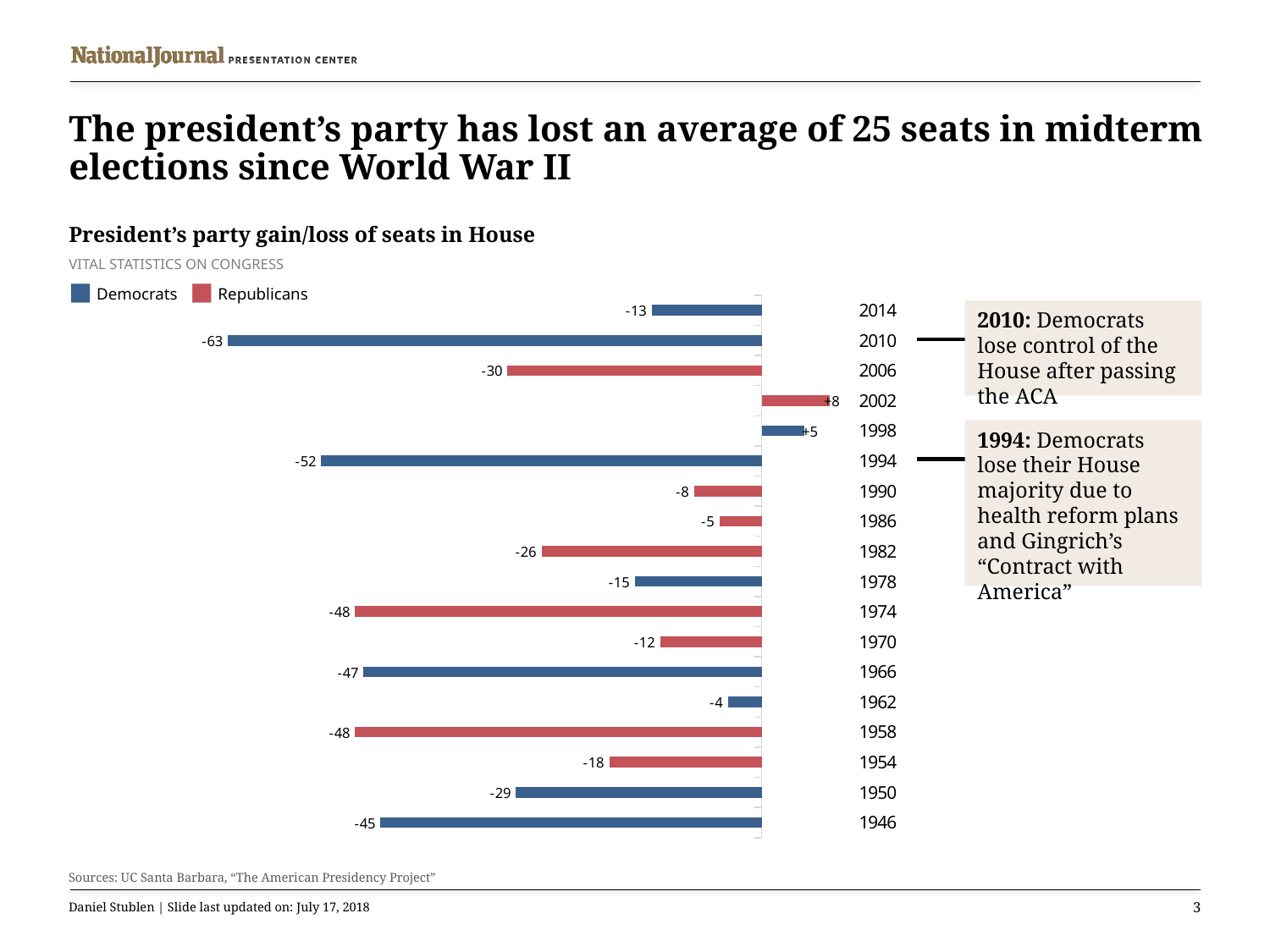
How many series does the legend list? 2 What is the difference between the values for 1994 and 2014? 39 Which colour represents Republicans in the chart? Red What kind of chart is shown on the slide? Bar chart Which year shows the largest loss of seats? 2010 What is the value for 1950? -29 What is the value for 2002? +8 How many midterm election years are plotted on the chart? 18 What is the value for 2010? -63 Which year shows the largest gain of seats? 2002 What is the value for 1974? -48 Which year shows a larger loss of seats, 1966 or 1982? 1966